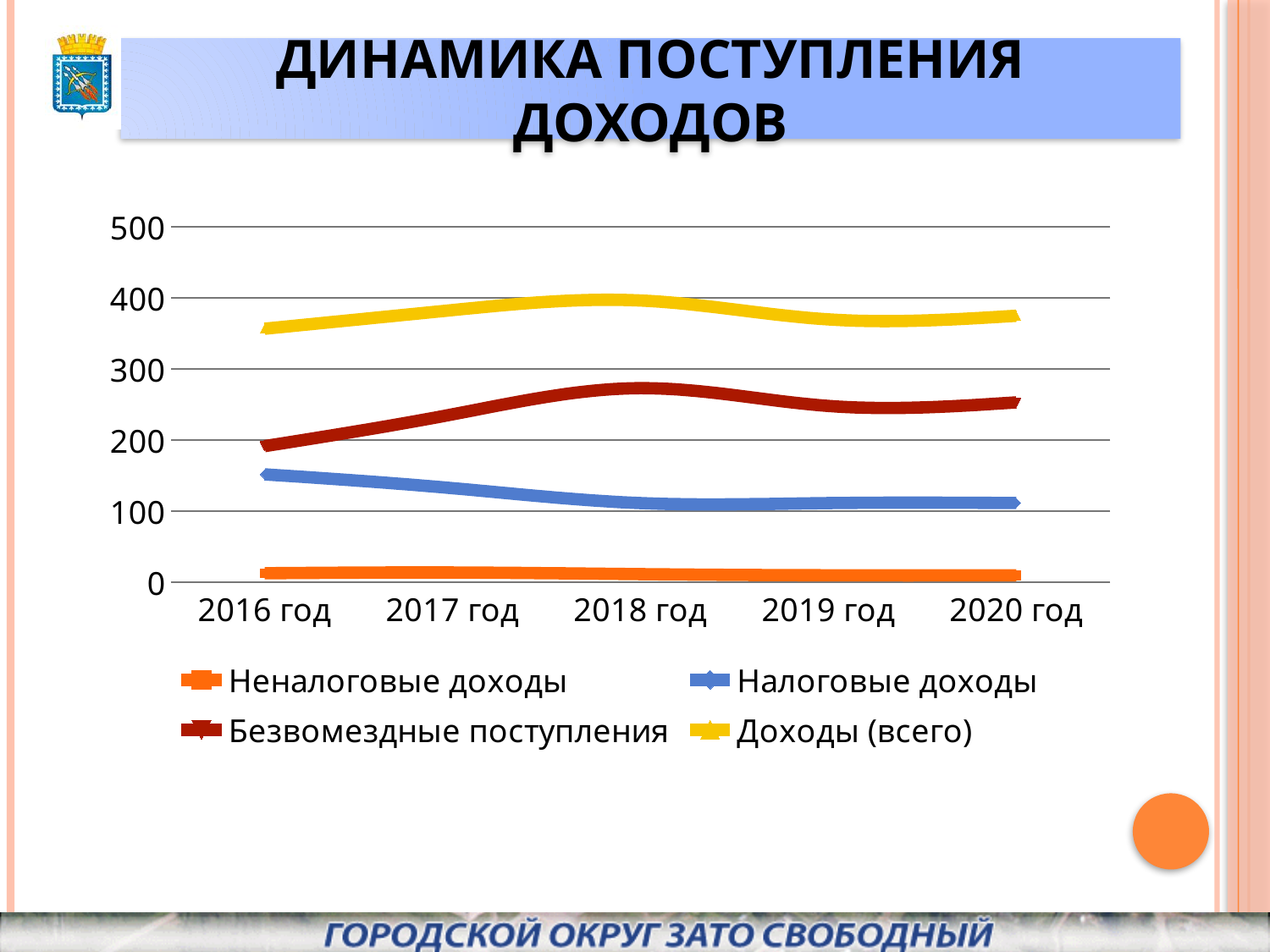
Which series has the highest values across all years? Доходы (всего) How many years are shown on the x axis? 5 Which series has the lowest values across all years? Неналоговые доходы Does the Налоговые доходы line rise or fall from 2016 год to 2018 год? fall How many series does the legend list? 4 Which is larger for Налоговые доходы: the value in 2016 год or in 2020 год? 2016 год What kind of chart is shown on the slide? line chart In which year does the Безвозмездные поступления line reach its highest point? 2018 год What is the title of the chart on the slide? ДИНАМИКА ПОСТУПЛЕНИЯ ДОХОДОВ Is the value for Доходы (всего) in 2016 год greater or less than 400? less Is the value for Безвозмездные поступления in 2018 год greater or less than 300? less Is the value for Налоговые доходы in 2016 год greater or less than 100? greater